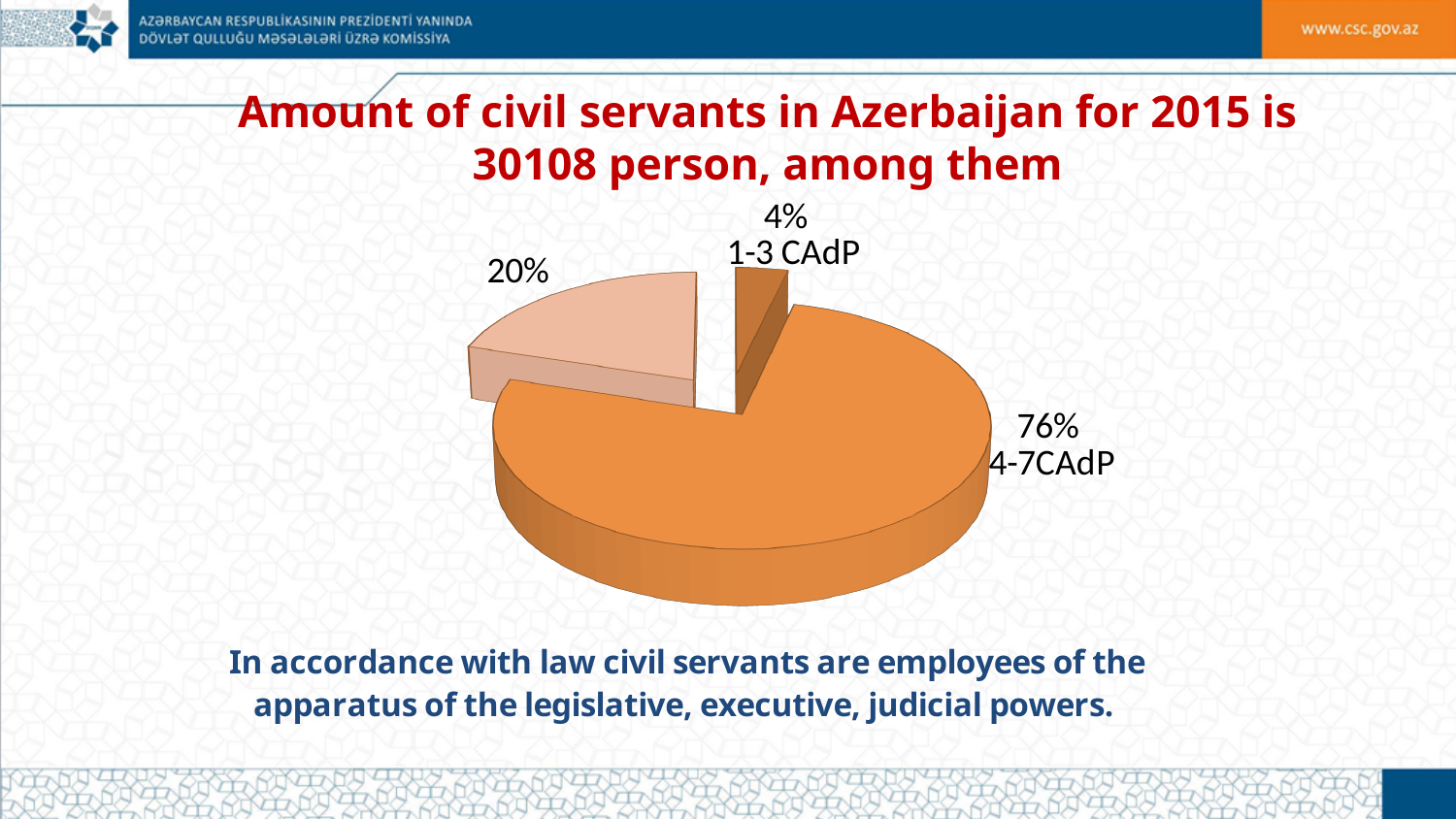
Which is larger, the 4-7CAdP slice or the 1-3 CAdP slice? 4-7CAdP What kind of chart is shown on the slide? pie chart What share of the pie does the 4-7CAdP slice represent? 76% What is the total number of civil servants stated in the chart title? 30108 Which year does the chart title refer to? 2015 How many slices does the pie chart have? 3 Which slice of the pie is the largest? 4-7CAdP What is the difference in percentage points between the 4-7CAdP slice and the 1-3 CAdP slice? 72 What percentage is shown for the light-coloured slice on the left of the pie? 20% What share of the pie does the 1-3 CAdP slice represent? 4% Which slice of the pie is the smallest? 1-3 CAdP